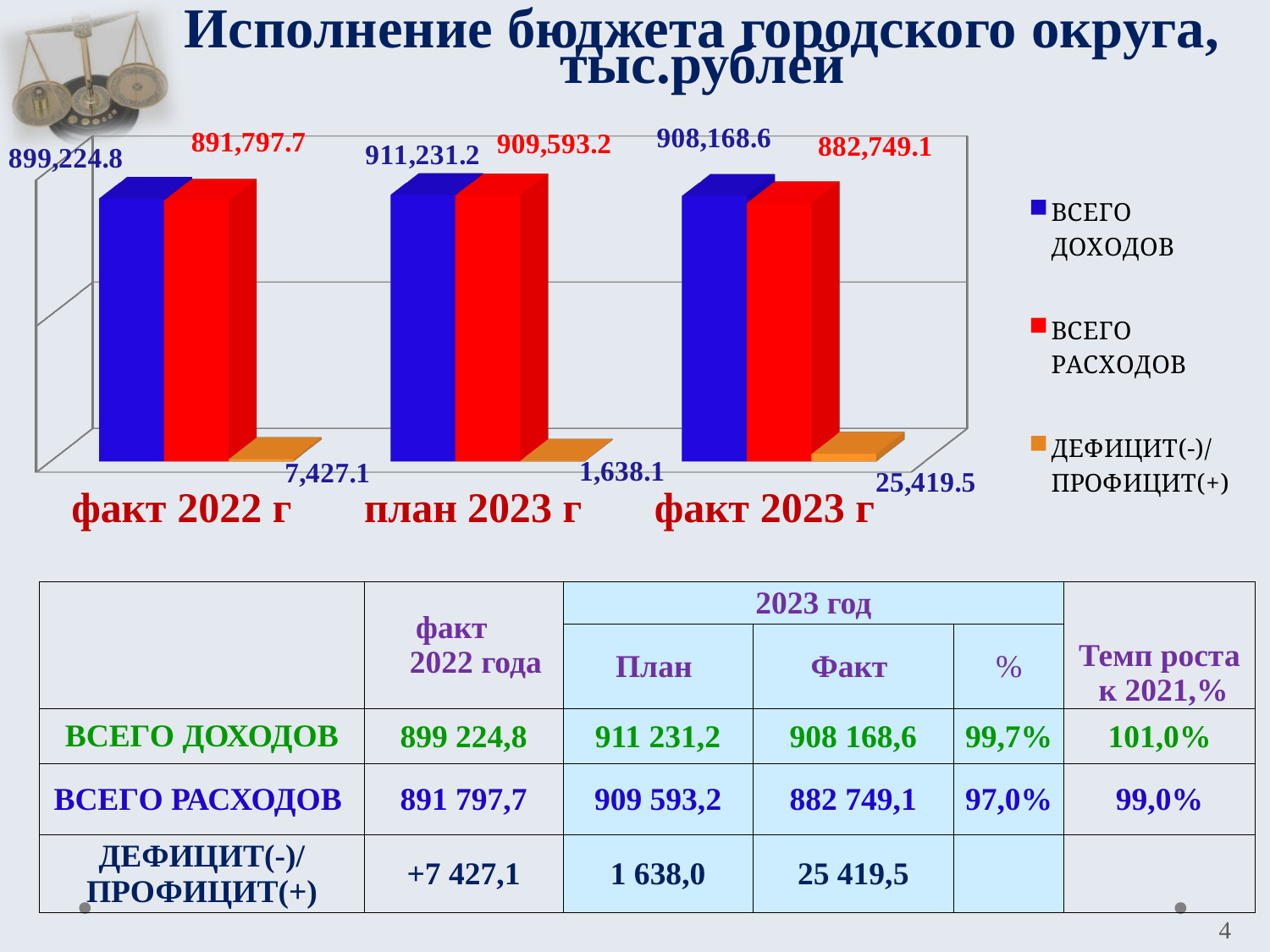
What is the value of ДЕФИЦИТ(-)/ПРОФИЦИТ(+) for факт 2023 г? 25,419.5 In which category is ДЕФИЦИТ(-)/ПРОФИЦИТ(+) the lowest? план 2023 г What kind of chart is shown on the slide? bar chart Which series is shown in red in the chart? ВСЕГО РАСХОДОВ What is the value of ВСЕГО РАСХОДОВ for факт 2023 г? 882,749.1 In which category is ВСЕГО РАСХОДОВ the lowest? факт 2023 г What is the value of ВСЕГО РАСХОДОВ for план 2023 г? 909,593.2 How many categories are shown along the x axis of the chart? 3 What is the difference between ВСЕГО ДОХОДОВ and ВСЕГО РАСХОДОВ for факт 2023 г? 25,419.5 In which category is ВСЕГО ДОХОДОВ the highest? план 2023 г How many series does the chart legend list? 3 What is the value of ВСЕГО ДОХОДОВ for факт 2022 г? 899,224.8